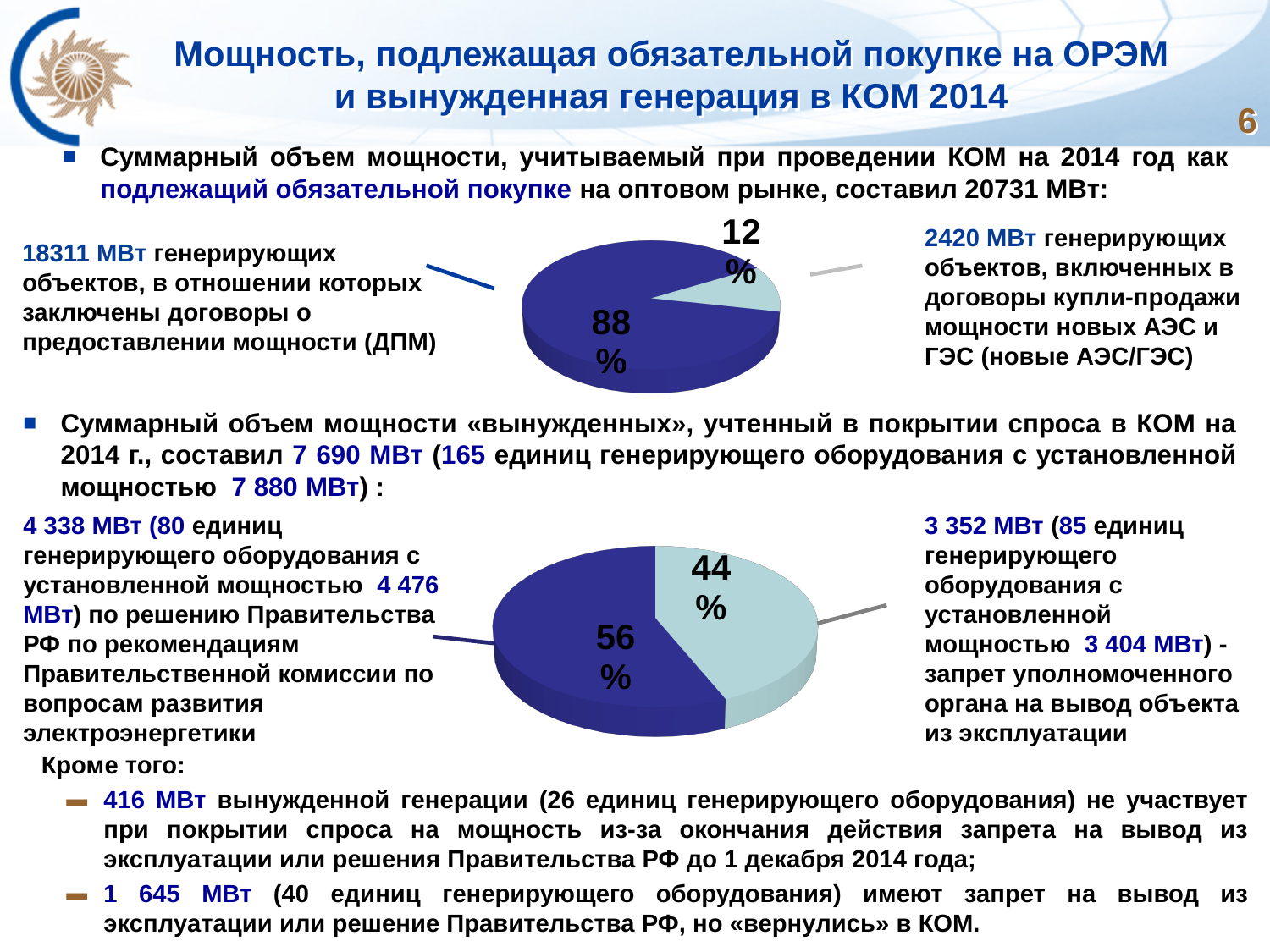
In the bottom pie chart, what share is shown for the light blue slice? 44% In the bottom pie chart, what is the difference in percentage points between the 56% slice and the 44% slice? 12 How many slices does the top pie chart have? 2 In the top pie chart, what share is shown for the larger (dark blue) slice? 88% In the bottom pie chart, which slice is larger, the dark blue one (56%) or the light blue one (44%)? the dark blue one (56%) In the top pie chart, what is the difference in percentage points between the 88% slice and the 12% slice? 76 What kind of chart is the bottom chart on the slide? pie chart What kind of chart is the top chart on the slide? pie chart In the top pie chart, what share is shown for the smaller (light blue) slice? 12% According to the text next to the top pie chart, how many MW correspond to the 88% slice (ДПМ)? 18311 МВт How many slices does the bottom pie chart have? 2